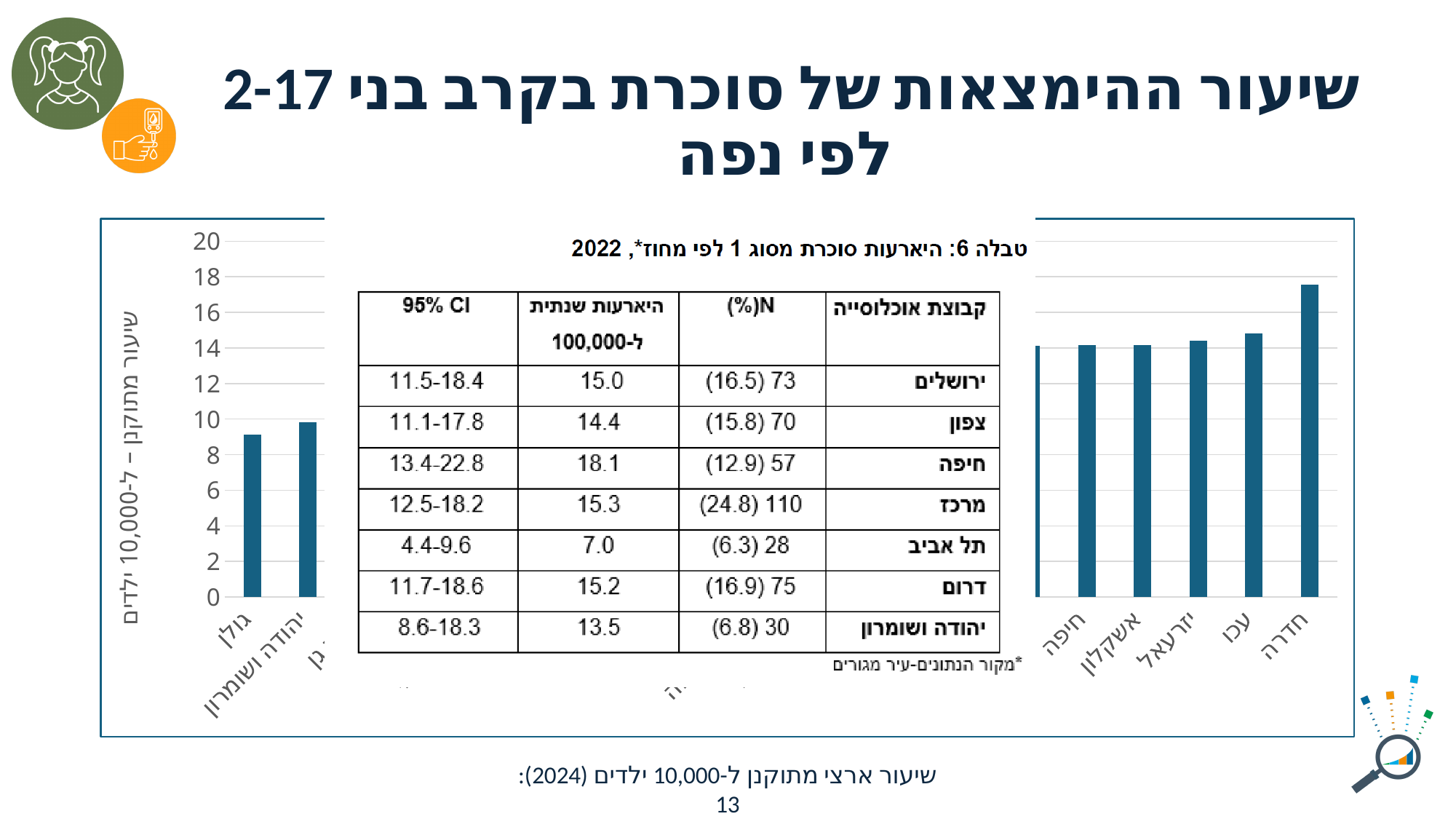
Is the value for אשקלון greater or less than 18? less Is the value for גולן greater or less than 10? less Which has a larger value, חדרה or גולן? חדרה Is the value for עכו greater or less than 16? less Do the bar values rise or fall from left to right along the x axis? rise What is the label of the vertical axis of the chart? שיעור מתוקנן – ל-10,000 ילדים Which has a larger value, יהודה ושומרון or יזרעאל? יזרעאל Which has a larger value, חדרה or עכו? חדרה What kind of chart is shown on the slide? bar chart